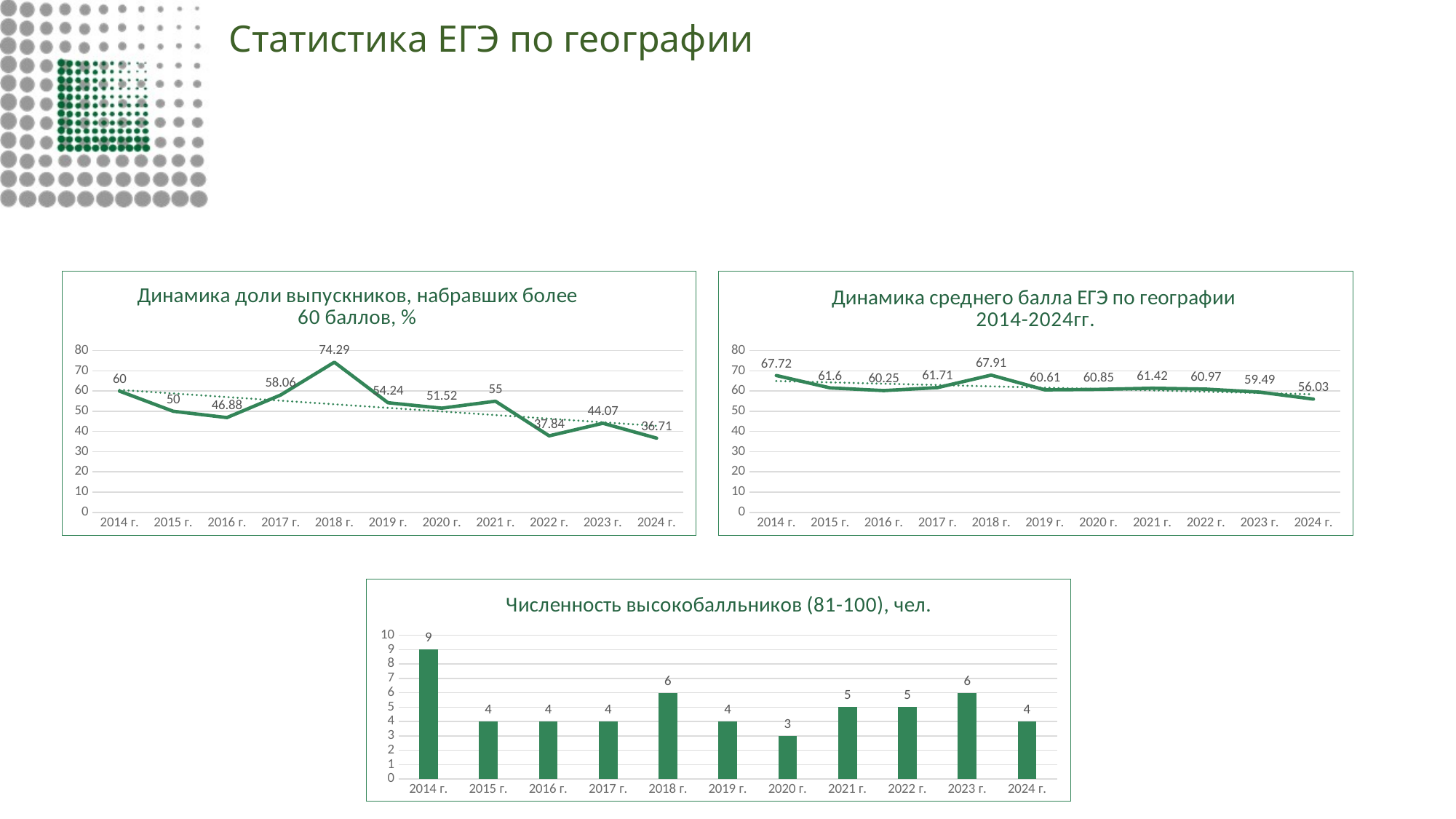
In the chart 'Динамика доли выпускников, набравших более 60 баллов, %', what is the value for 2018 г.? 74.29 In the chart 'Численность высокобалльников (81-100), чел.', what is the difference between the values for 2018 г. and 2020 г.? 3 In the chart 'Динамика среднего балла ЕГЭ по географии 2014-2024гг.', which is larger, the value for 2014 г. or the value for 2024 г.? 2014 г. In the chart 'Динамика среднего балла ЕГЭ по географии 2014-2024гг.', which year has the highest value? 2018 г. In the chart 'Динамика доли выпускников, набравших более 60 баллов, %', what is the difference between the values for 2014 г. and 2024 г.? 23.29 What kind of chart is 'Динамика среднего балла ЕГЭ по географии 2014-2024гг.'? Line chart In the chart 'Динамика доли выпускников, набравших более 60 баллов, %', how many years are plotted on the x axis? 11 In the chart 'Численность высокобалльников (81-100), чел.', what is the value for 2014 г.? 9 In the chart 'Динамика среднего балла ЕГЭ по географии 2014-2024гг.', what is the value for 2023 г.? 59.49 In the chart 'Численность высокобалльников (81-100), чел.', which year has the lowest value? 2020 г. In the chart 'Динамика доли выпускников, набравших более 60 баллов, %', which year has the lowest value? 2024 г. What kind of chart is 'Численность высокобалльников (81-100), чел.'? Bar chart